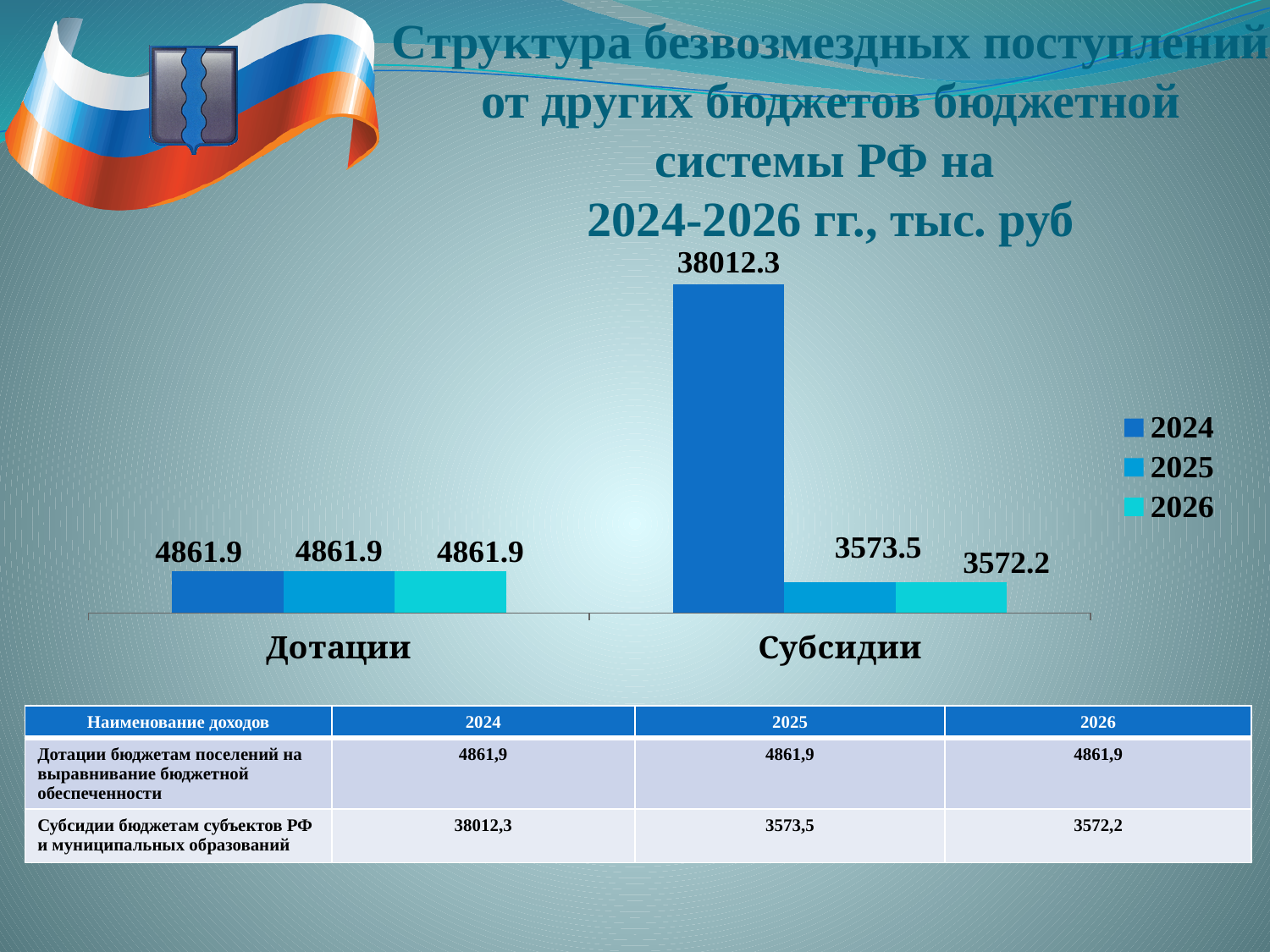
What is the value for Дотации in 2025? 4861.9 What is the value for Субсидии in 2025? 3573.5 What is the value for Субсидии in 2026? 3572.2 Which category has the lowest value in 2026? Субсидии What is the difference between the 2024 and 2025 values for Субсидии? 34438.8 How many series does the legend list? 3 Which category has the highest value in 2024? Субсидии What kind of chart is shown on the slide? bar chart What is the value for Субсидии in 2024? 38012.3 Do the values for Субсидии rise or fall from 2024 to 2026? fall How many categories are shown on the x axis? 2 Which is larger: Дотации in 2026 or Субсидии in 2026? Дотации